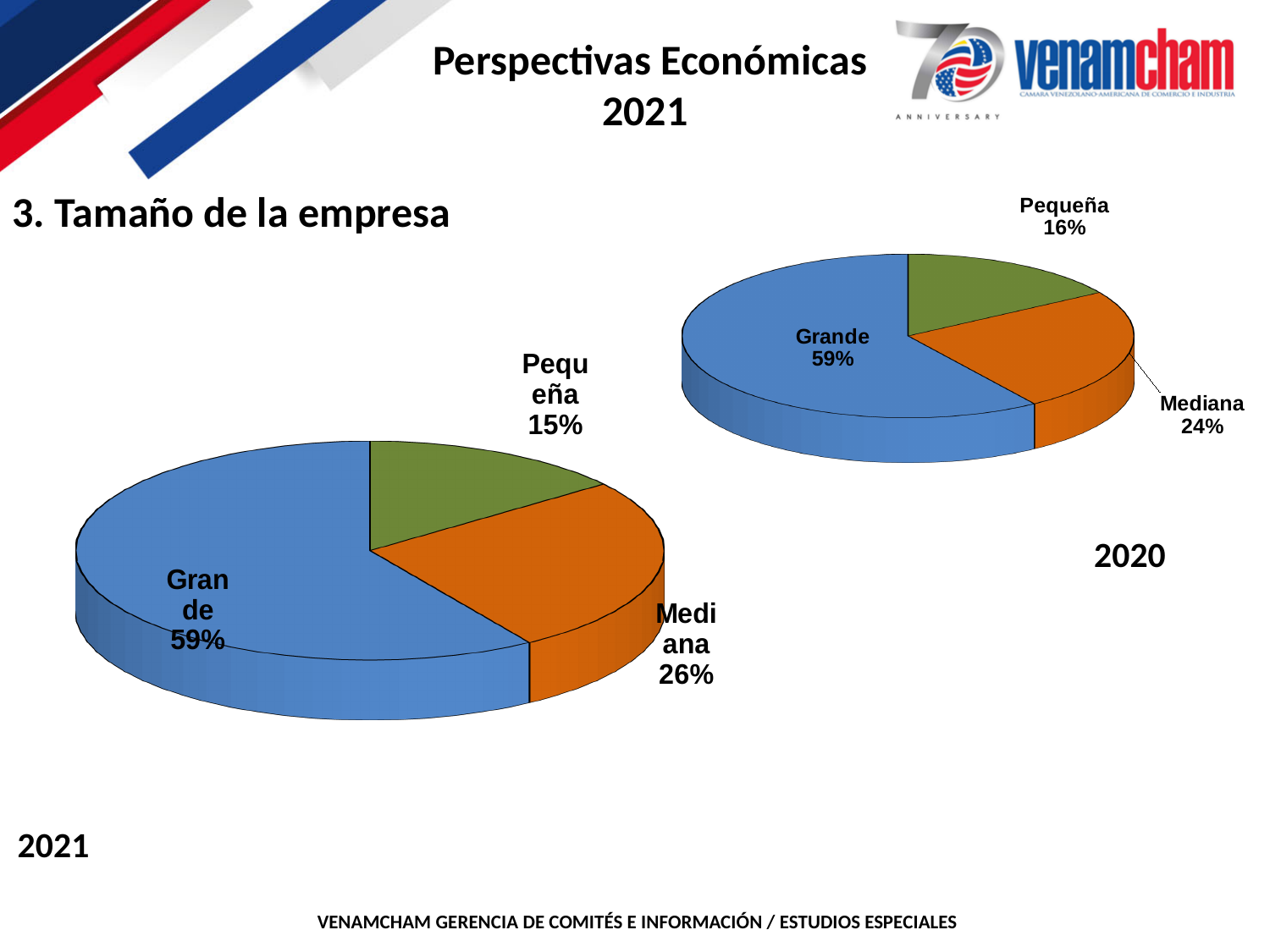
In the 2020 pie chart, which category has the largest share? Grande Is the Mediana share larger in the 2020 pie chart or the 2021 pie chart? 2021 In the 2020 pie chart, what share does Mediana have? 24% In the 2020 pie chart, what share does Pequeña have? 16% In the 2021 pie chart, what share does Pequeña have? 15% In the 2021 pie chart, which category has the smallest share? Pequeña In the 2021 pie chart, what share does Mediana have? 26% How many categories does the 2020 pie chart show? 3 In the 2021 pie chart, what is the difference between the Grande and Mediana shares? 33% In the 2021 pie chart, what share does Grande have? 59% In the 2021 pie chart, what colour is the Grande slice? Blue What kind of chart is the 2021 chart? Pie chart